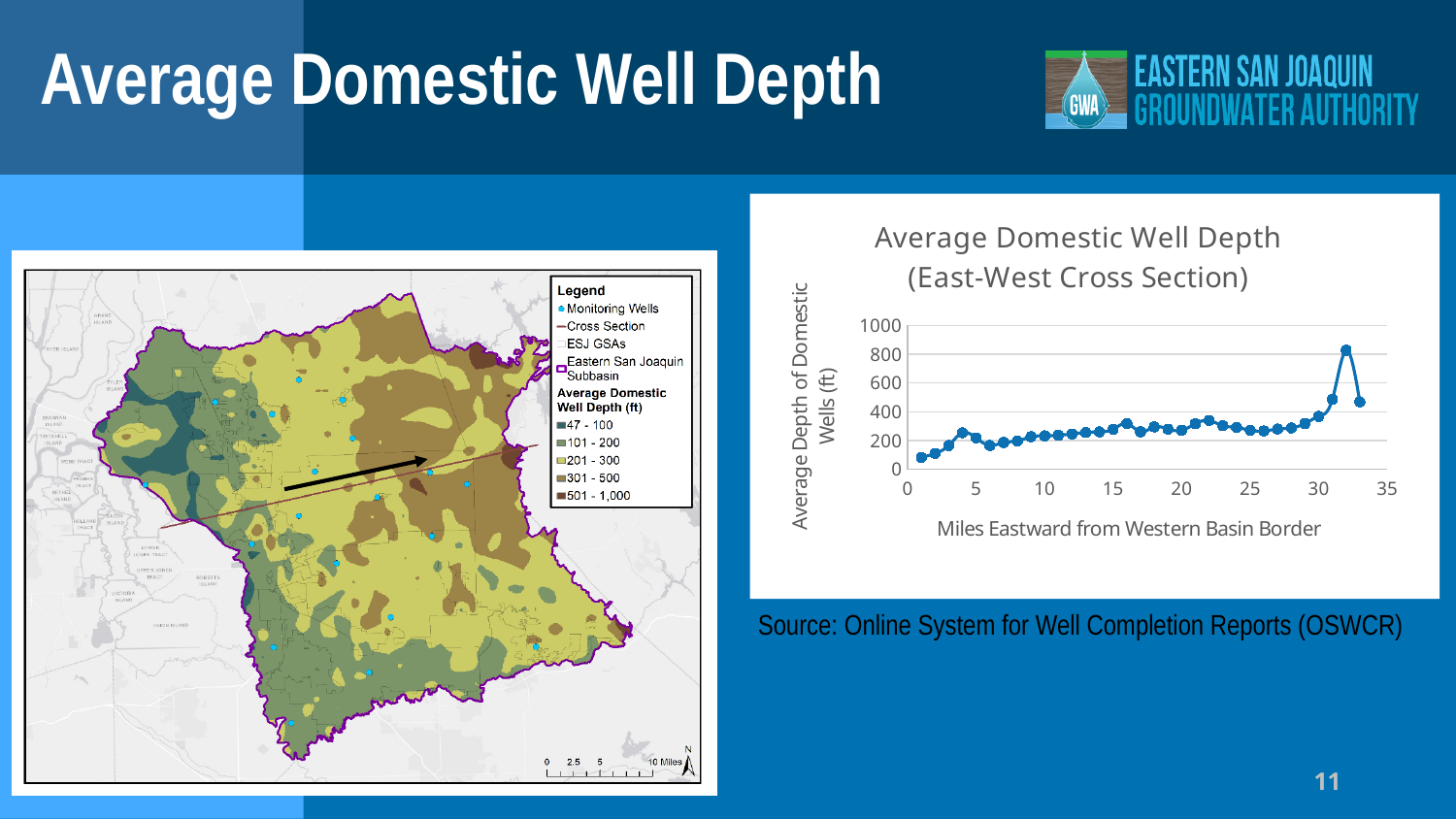
What is the x-axis label of the 'Average Domestic Well Depth (East-West Cross Section)' chart? Miles Eastward from Western Basin Border In the 'Average Domestic Well Depth (East-West Cross Section)' chart, do the values generally rise or fall moving eastward along the x axis? rise In the 'Average Domestic Well Depth (East-West Cross Section)' chart, is the highest plotted value greater or less than 600? greater In the 'Average Domestic Well Depth (East-West Cross Section)' chart, is the value at around mile 20 greater or less than 600? less In the 'Average Domestic Well Depth (East-West Cross Section)' chart, is the value at the first point (around mile 1) greater or less than 200? less What kind of chart is the 'Average Domestic Well Depth (East-West Cross Section)' chart? line chart In the 'Average Domestic Well Depth (East-West Cross Section)' chart, is the value at around mile 32 larger or smaller than the value at around mile 1? larger What is the maximum value shown on the y axis of the 'Average Domestic Well Depth (East-West Cross Section)' chart? 1000 What is the title of the chart on the right side of the slide? Average Domestic Well Depth (East-West Cross Section) In the 'Average Domestic Well Depth (East-West Cross Section)' chart, roughly at which mile does the peak (highest) value occur: near mile 5 or near mile 32? near mile 32